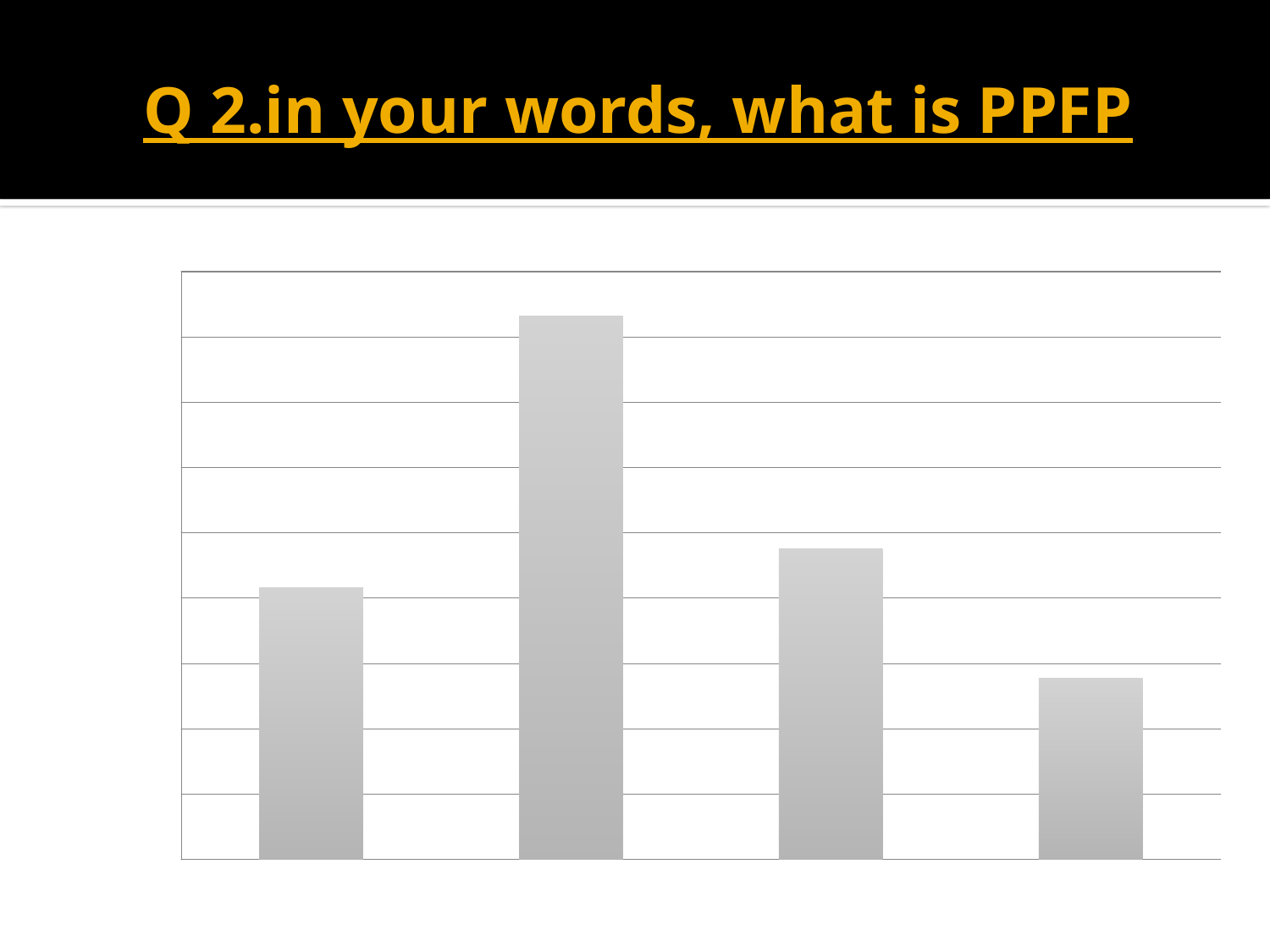
How many bars does the chart show? 4 Which bar, counting from the left, is the shortest? the fourth bar Which bar, counting from the left, is the tallest? the second bar What kind of chart is shown on the slide? bar chart What is the title shown at the top of the slide? Q 2.in your words, what is PPFP Which is taller, the second bar from the left or the fourth bar from the left? the second bar Which is taller, the first bar from the left or the fourth bar from the left? the first bar Which is taller, the first bar from the left or the third bar from the left? the third bar Does the chart display any data labels on the bars? No